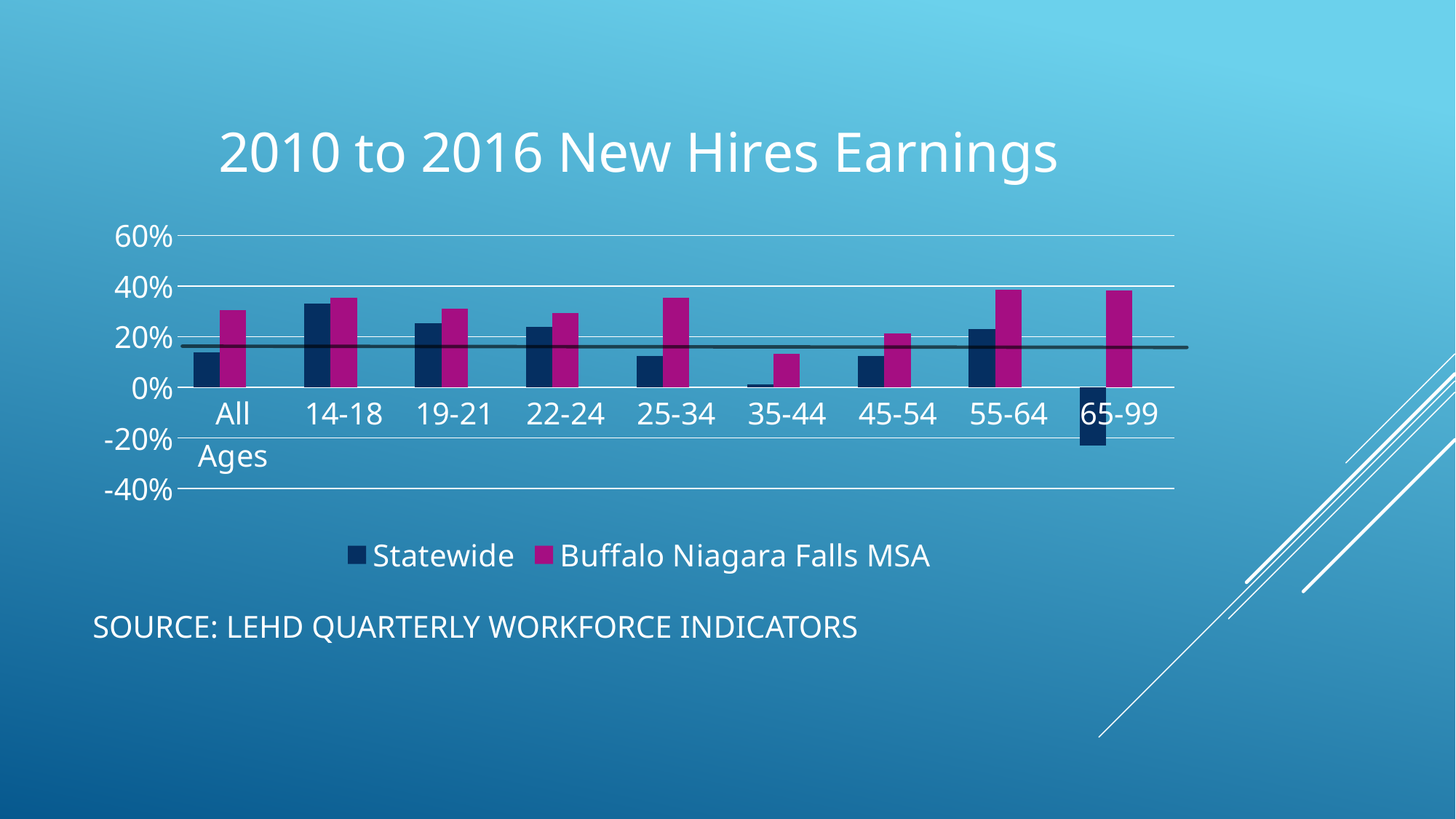
Which is larger: the Statewide value for 19-21 or the Statewide value for 45-54? 19-21 Is the Statewide value for 35-44 greater or less than 20%? less What is the title of the chart? 2010 to 2016 New Hires Earnings For the 25-34 age group, which series has the larger value, Statewide or Buffalo Niagara Falls MSA? Buffalo Niagara Falls MSA Which age category has the lowest Statewide value? 65-99 What kind of chart is shown on the slide? bar chart How many age categories are shown on the x axis? 9 Which age category has the highest Statewide value? 14-18 How many series does the legend list? 2 Which age category has the lowest Buffalo Niagara Falls MSA value? 35-44 Is the Statewide value for 65-99 greater or less than 0%? less Is the Buffalo Niagara Falls MSA value for 25-34 greater or less than 20%? greater